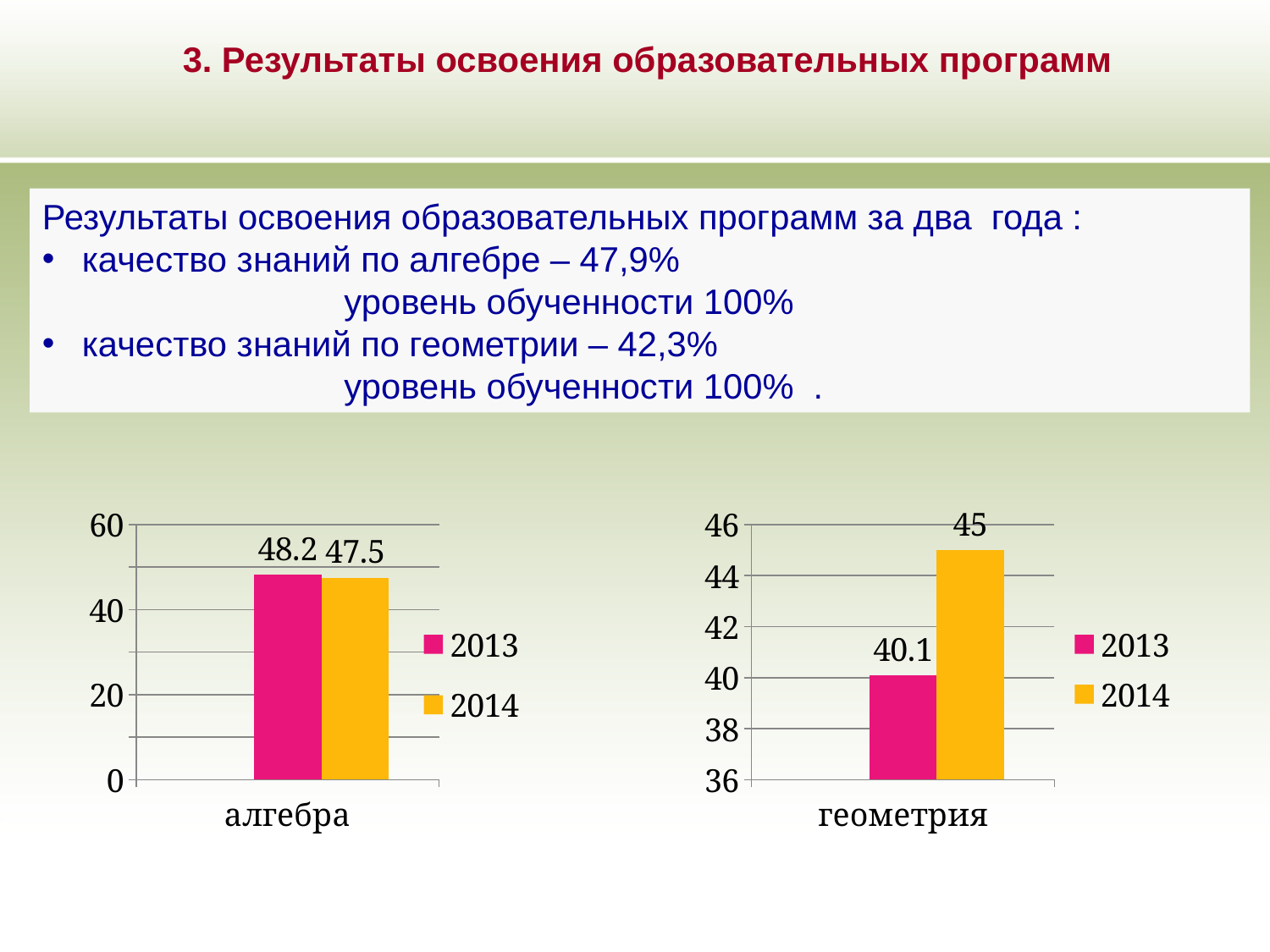
In the right chart (геометрия), what is the value for 2013? 40.1 In the right chart (геометрия), what is the difference between the 2014 and 2013 values? 4.9 In the left chart (алгебра), which year has the lower value? 2014 How many series does the legend of the right chart (геометрия) list? 2 In the left chart (алгебра), is the value for 2013 greater or less than 40? greater In the right chart (геометрия), which colour represents 2014? yellow/orange What kind of chart is the left chart (алгебра)? bar chart In the left chart (алгебра), what is the value for 2013? 48.2 In the right chart (геометрия), what is the value for 2014? 45 In the right chart (геометрия), which year has the higher value? 2014 In the left chart (алгебра), what is the value for 2014? 47.5 In the left chart (алгебра), what is the difference between the 2013 and 2014 values? 0.7